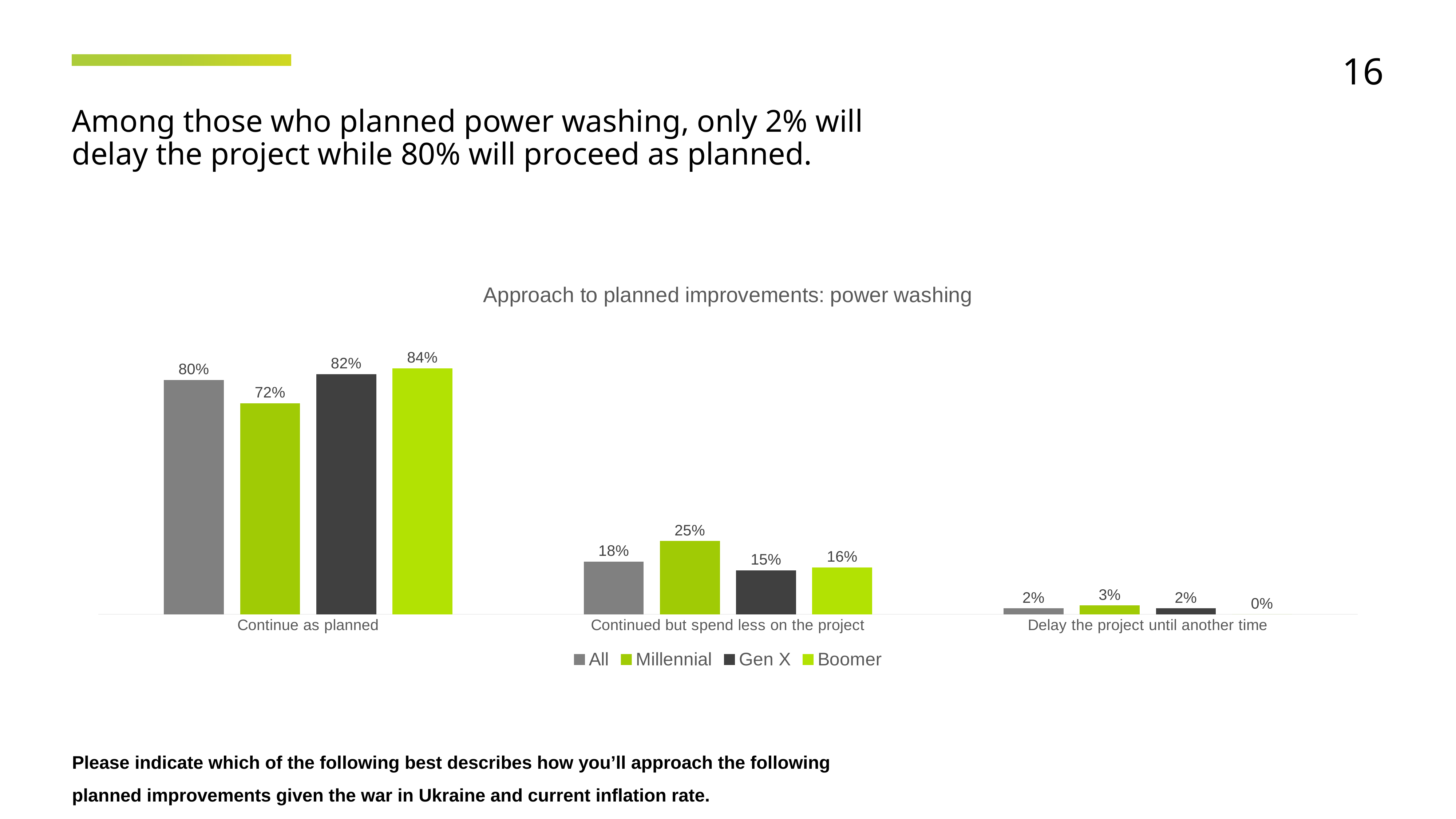
How many categories are shown on the x axis? 3 What is the value for Millennial in the 'Continue as planned' category? 72% Which is larger in the 'Continued but spend less on the project' category: All or Millennial? Millennial What is the title of the chart? Approach to planned improvements: power washing How many series does the legend list? 4 What is the difference between the Boomer and Millennial values in the 'Continue as planned' category? 12% Do the values for the All series rise or fall across the categories from left to right? Fall What is the value for Gen X in the 'Delay the project until another time' category? 2% What is the value for Boomer in the 'Continued but spend less on the project' category? 16% Which series has the highest value in the 'Continue as planned' category? Boomer Which series has the lowest value in the 'Continued but spend less on the project' category? Gen X What kind of chart is shown on the slide? Bar chart